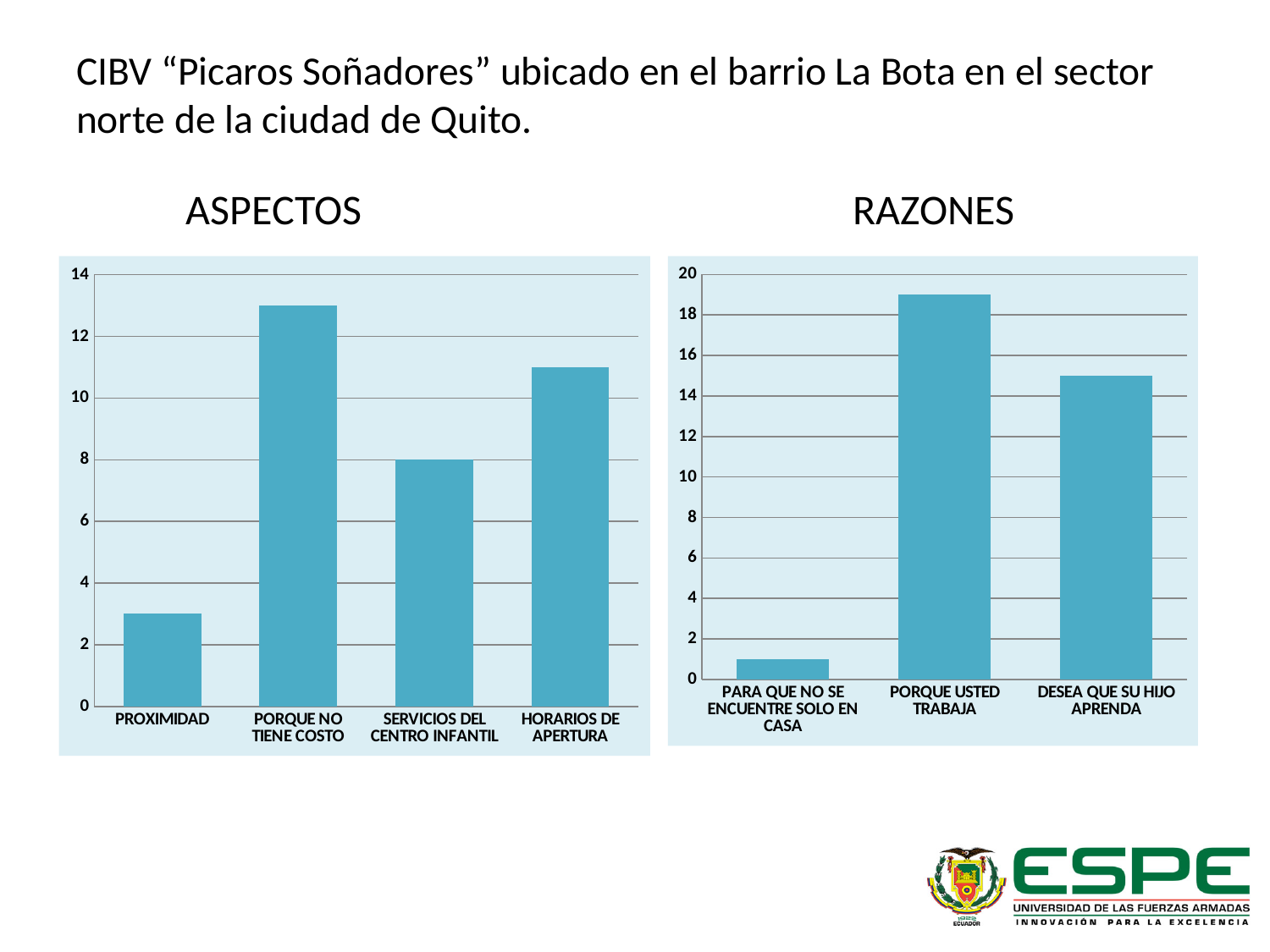
In the ASPECTOS chart, what is the value for SERVICIOS DEL CENTRO INFANTIL? 8 In the ASPECTOS chart, which category has the highest value? PORQUE NO TIENE COSTO In the ASPECTOS chart, is the value for PROXIMIDAD greater or less than 4? less How many categories are shown in the ASPECTOS chart? 4 In the RAZONES chart, which category has the highest value? PORQUE USTED TRABAJA In the RAZONES chart, which category has the lowest value? PARA QUE NO SE ENCUENTRE SOLO EN CASA What type of chart is the RAZONES chart? Bar chart In the ASPECTOS chart, which category has the lowest value? PROXIMIDAD In the ASPECTOS chart, is the value for PORQUE NO TIENE COSTO greater or less than 12? greater In the ASPECTOS chart, which is larger, HORARIOS DE APERTURA or SERVICIOS DEL CENTRO INFANTIL? HORARIOS DE APERTURA How many categories are shown in the RAZONES chart? 3 In the RAZONES chart, is the value for DESEA QUE SU HIJO APRENDA greater or less than 14? greater